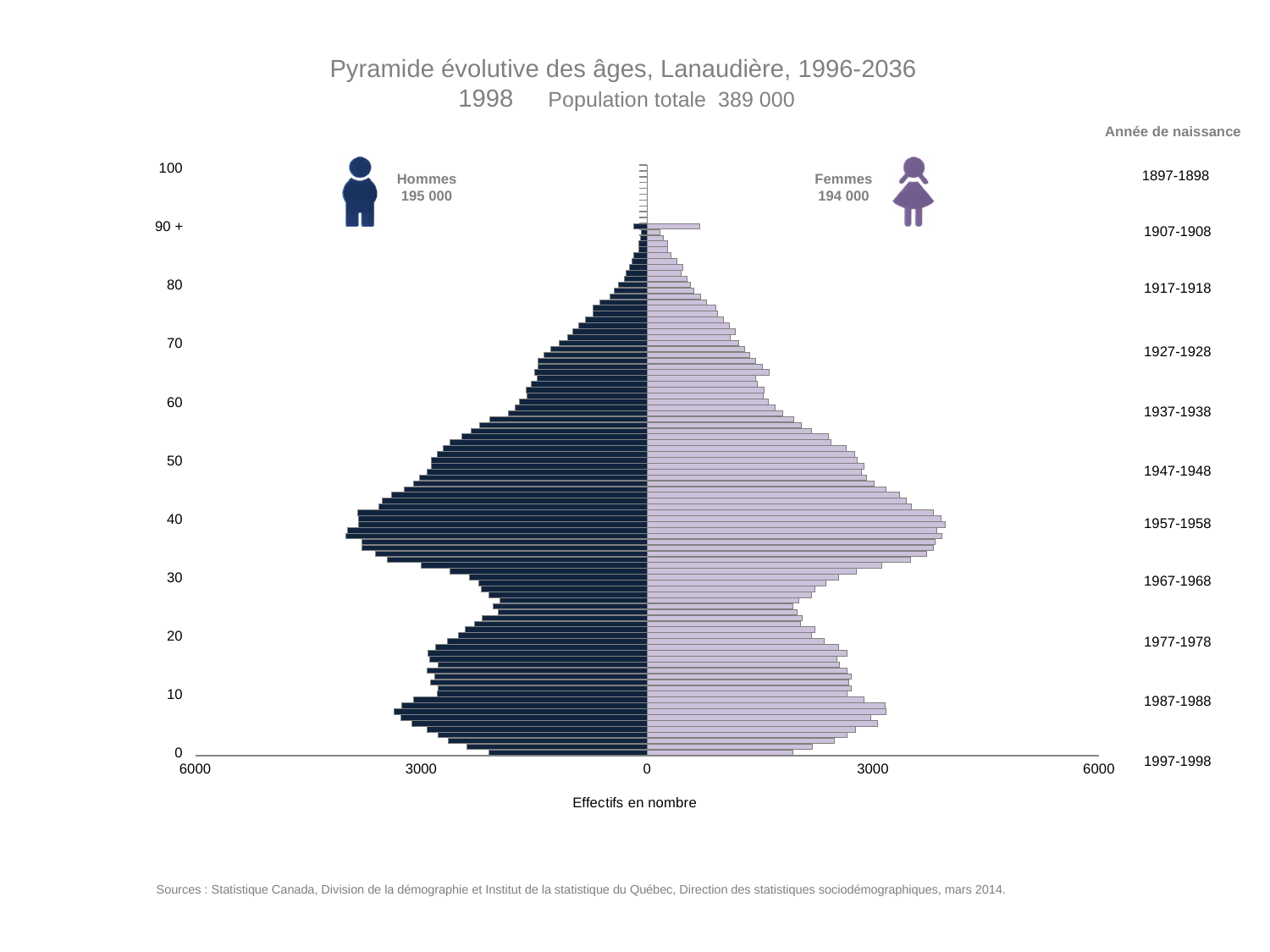
What is the label of the horizontal axis? Effectifs en nombre What is the difference between the Hommes total and the Femmes total? 1 000 Do the bar lengths rise or fall as age increases from 40 to 80? fall Is the number of Femmes at age 80 greater or less than 3000? less What is the total number of Femmes shown on the chart? 194 000 What is the total population shown for 1998? 389 000 Is the number of Femmes at age 25 greater or less than 3000? less What is the total number of Hommes shown on the chart? 195 000 Which group has the larger total, Hommes or Femmes? Hommes Is the number of Hommes at age 38 greater or less than 3000? greater What is the title of the chart? Pyramide évolutive des âges, Lanaudière, 1996-2036 What kind of chart is shown on the slide? bar chart